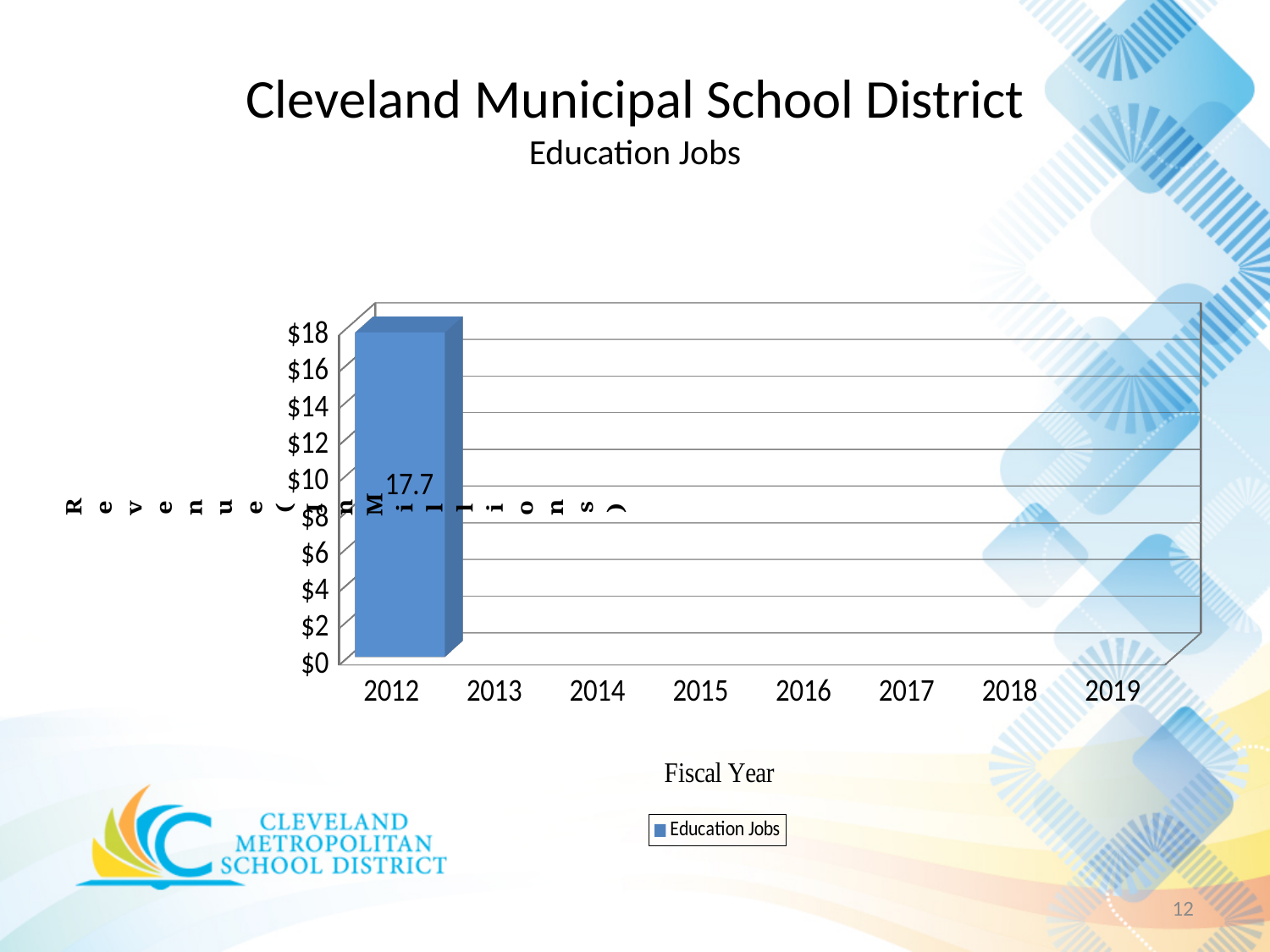
What kind of chart is shown on the slide? bar chart Which fiscal year is the only one with a plotted bar? 2012 Is the value for 2012 greater or less than $10? greater What is the value shown for fiscal year 2012? 17.7 How many fiscal years are shown along the x axis? 8 What is the title of the x axis? Fiscal Year What is the name of the series listed in the legend? Education Jobs Which fiscal year has the highest value in the chart? 2012 Is the value for 2012 greater or less than $16? greater How many series does the legend list? 1 What is the first fiscal year shown on the x axis? 2012 What is the last fiscal year shown on the x axis? 2019